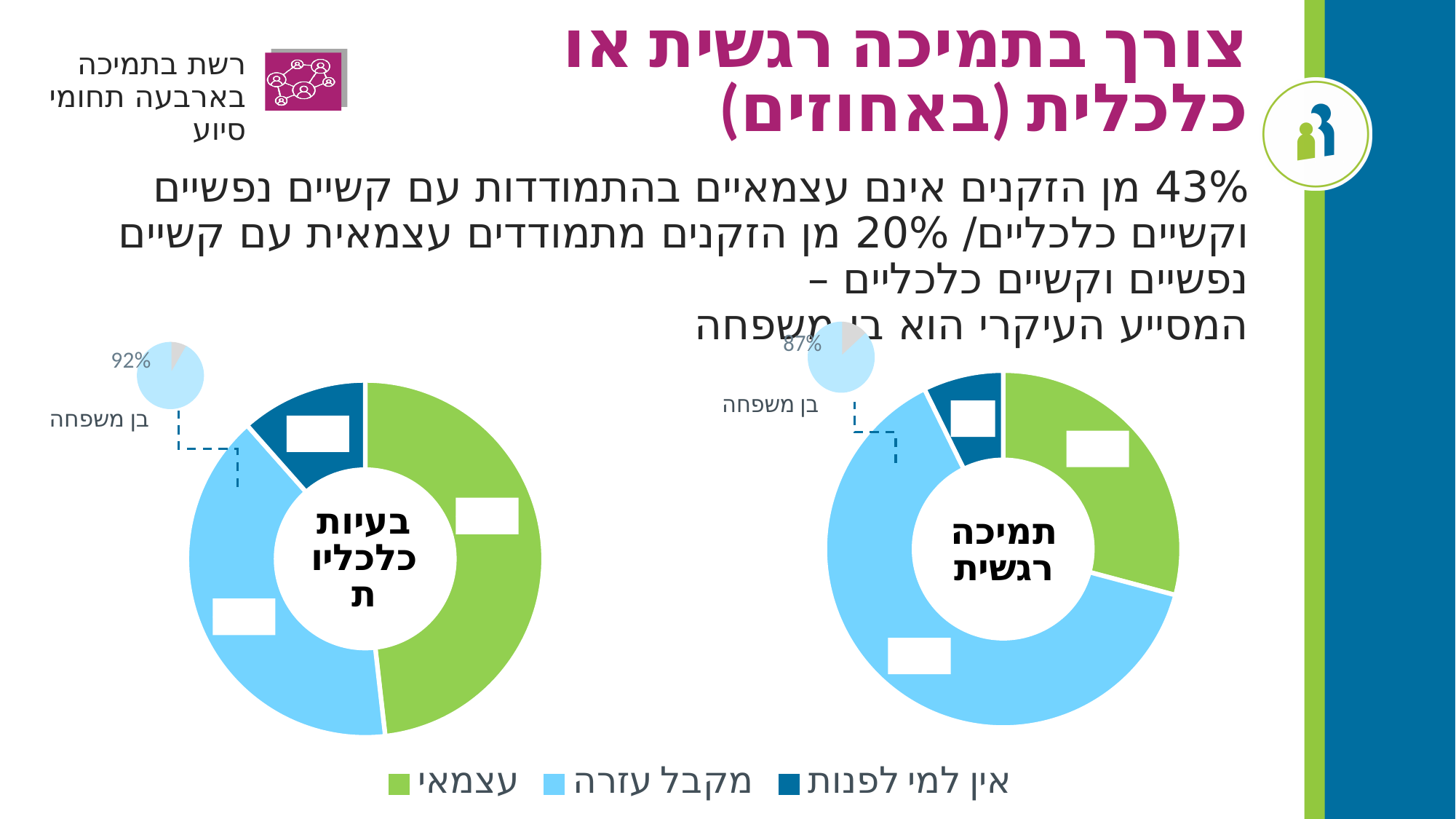
What percentage is shown in the small callout labelled בן משפחה next to the right chart titled תמיכה רגשית? 87% In the left chart titled בעיות כלכליות, which slice is larger: עצמאי or מקבל עזרה? עצמאי In the right chart titled תמיכה רגשית, which category has the largest slice? מקבל עזרה What kind of chart is the left chart titled בעיות כלכליות? Pie (donut) chart How many donut charts are shown on the slide? 2 What percentage is shown in the small callout labelled בן משפחה next to the left chart titled בעיות כלכליות? 92% How many categories does the legend list for the charts? 3 Which colour represents the category אין למי לפנות in the legend? Dark blue In the right chart titled תמיכה רגשית, which slice is larger: עצמאי or מקבל עזרה? מקבל עזרה In the right chart titled תמיכה רגשית, which category has the smallest slice? אין למי לפנות In the left chart titled בעיות כלכליות, which category has the largest slice? עצמאי In the left chart titled בעיות כלכליות, which category has the smallest slice? אין למי לפנות